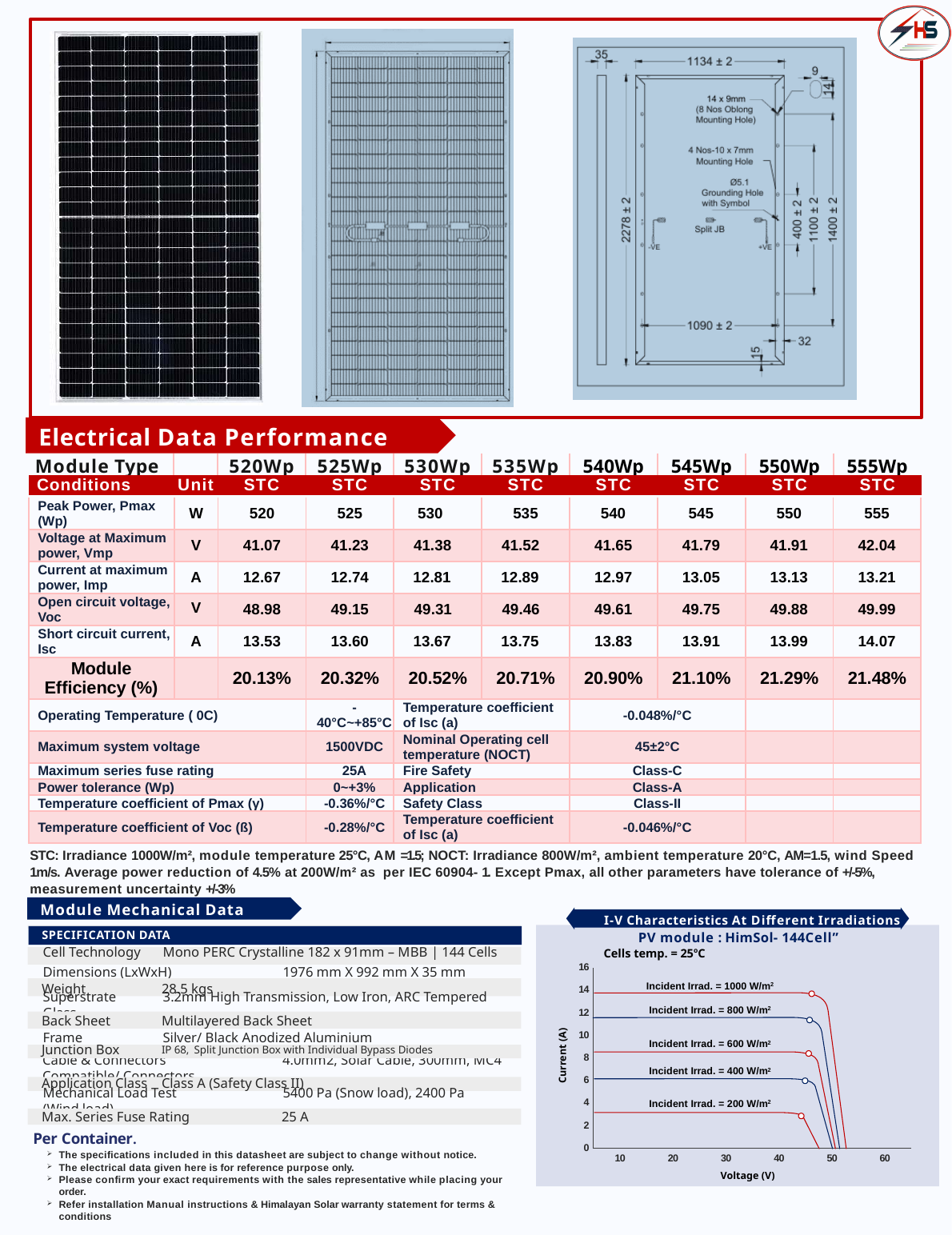
On the I-V Characteristics chart, is the plateau current of the 1000 W/m² curve greater or less than 12 A? greater On the I-V Characteristics chart, is the plateau current of the 200 W/m² curve greater or less than 4 A? less On the I-V Characteristics chart, which incident irradiance curve has the lowest current? 200 W/m² What cell temperature is stated for the I-V Characteristics chart? 25°C How many irradiance curves are plotted on the I-V Characteristics chart? 5 On the I-V Characteristics chart, is the plateau current of the 600 W/m² curve greater or less than 10 A? less What kind of chart is the I-V Characteristics chart on the slide? line chart On the I-V Characteristics chart, which curve shows a higher current: 800 W/m² or 600 W/m²? 800 W/m² On the I-V Characteristics chart, how does the current change as voltage increases beyond about 45 V? it falls sharply What is the label of the x axis on the I-V Characteristics chart? Voltage (V) On the I-V Characteristics chart, which incident irradiance curve reaches the highest current? 1000 W/m²